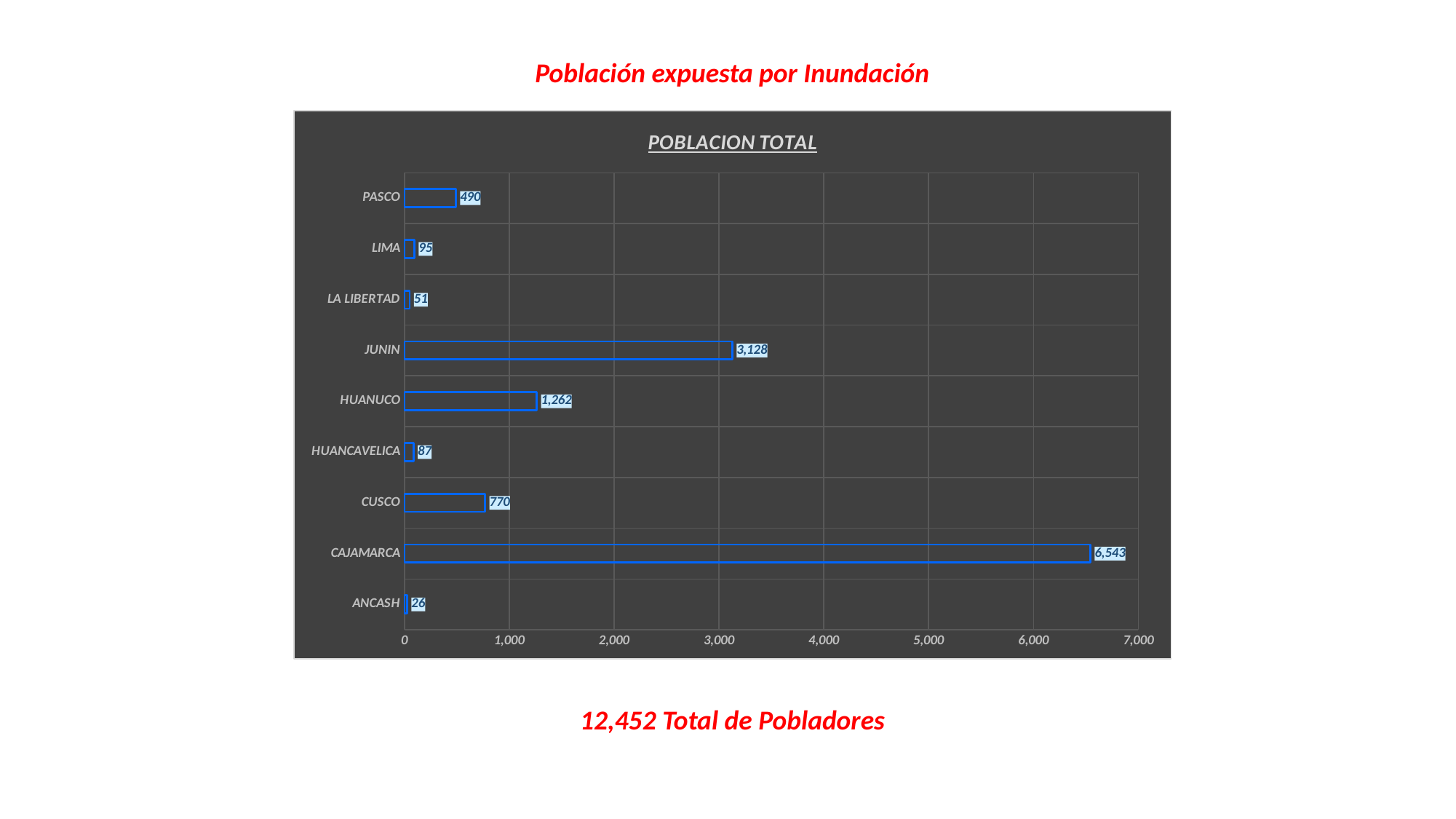
Is the value for HUANUCO greater or less than 1,000? greater What is the title of the chart? POBLACION TOTAL Which category has the lowest value? ANCASH How many categories are shown in the chart? 9 What is the difference between the values for CAJAMARCA and JUNIN? 3,415 What kind of chart is shown on the slide? bar chart What is the difference between the values for CUSCO and PASCO? 280 Which is larger, the value for LIMA or the value for HUANCAVELICA? LIMA What is the value for JUNIN? 3,128 What is the value for PASCO? 490 Which category has the highest value? CAJAMARCA What is the value for HUANUCO? 1,262